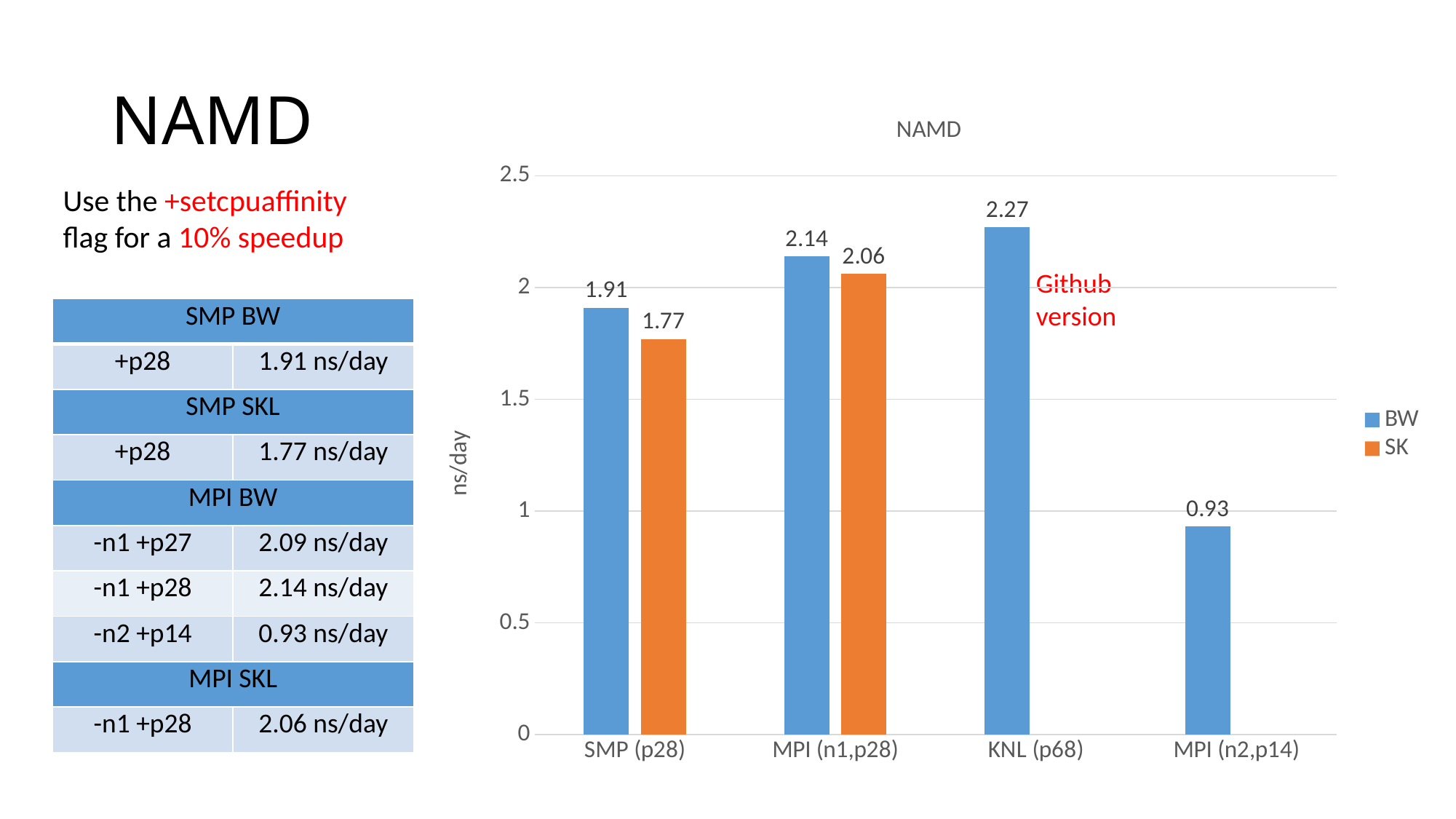
What kind of chart is shown? Bar chart What is the BW value for MPI (n2,p14)? 0.93 What is the BW value for KNL (p68)? 2.27 How many categories are shown on the x axis? 4 What is the label of the y axis? ns/day Which category has the lowest BW value? MPI (n2,p14) Which is larger for MPI (n1,p28), the BW value or the SK value? BW What is the difference between the BW and SK values for SMP (p28)? 0.14 How many series does the legend list? 2 Which category has the highest BW value? KNL (p68) What is the SK value for MPI (n1,p28)? 2.06 What is the BW value for SMP (p28)? 1.91